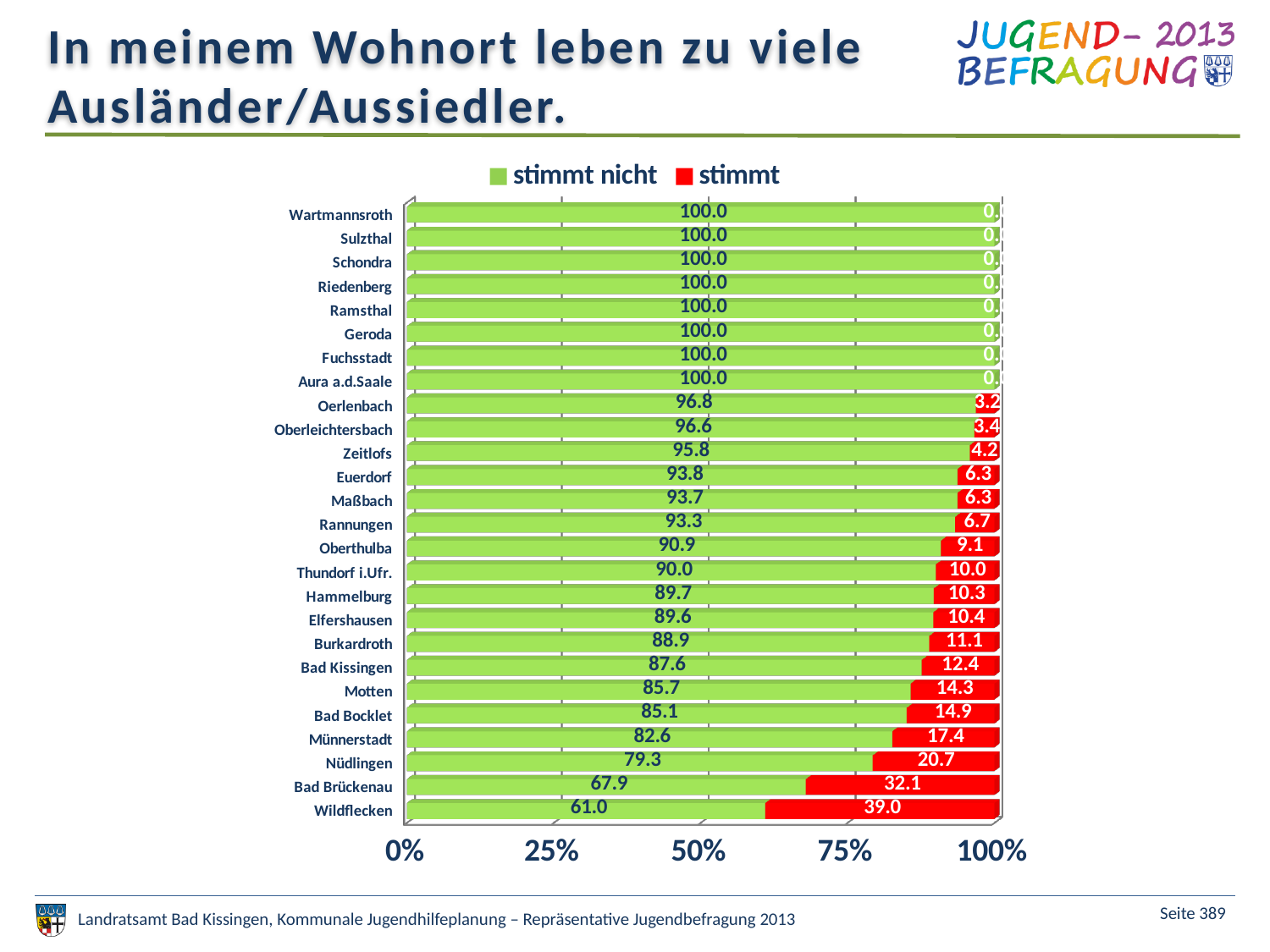
Which has a larger "stimmt" value, Nüdlingen or Münnerstadt? Nüdlingen Which municipality has the lowest "stimmt nicht" value? Wildflecken How many series does the legend list? 2 What is the total of the stacked bar for Bad Kissingen? 100.0 What kind of chart is shown on the slide? Stacked bar chart What is the "stimmt" value for Wildflecken? 39.0 Which colour represents the "stimmt" series? Red What is the difference between the "stimmt" values for Wildflecken and Bad Brückenau? 6.9 How many municipalities are shown in the chart? 26 What is the "stimmt" value for Hammelburg? 10.3 What is the "stimmt nicht" value for Bad Brückenau? 67.9 Which municipality has the highest "stimmt" value? Wildflecken